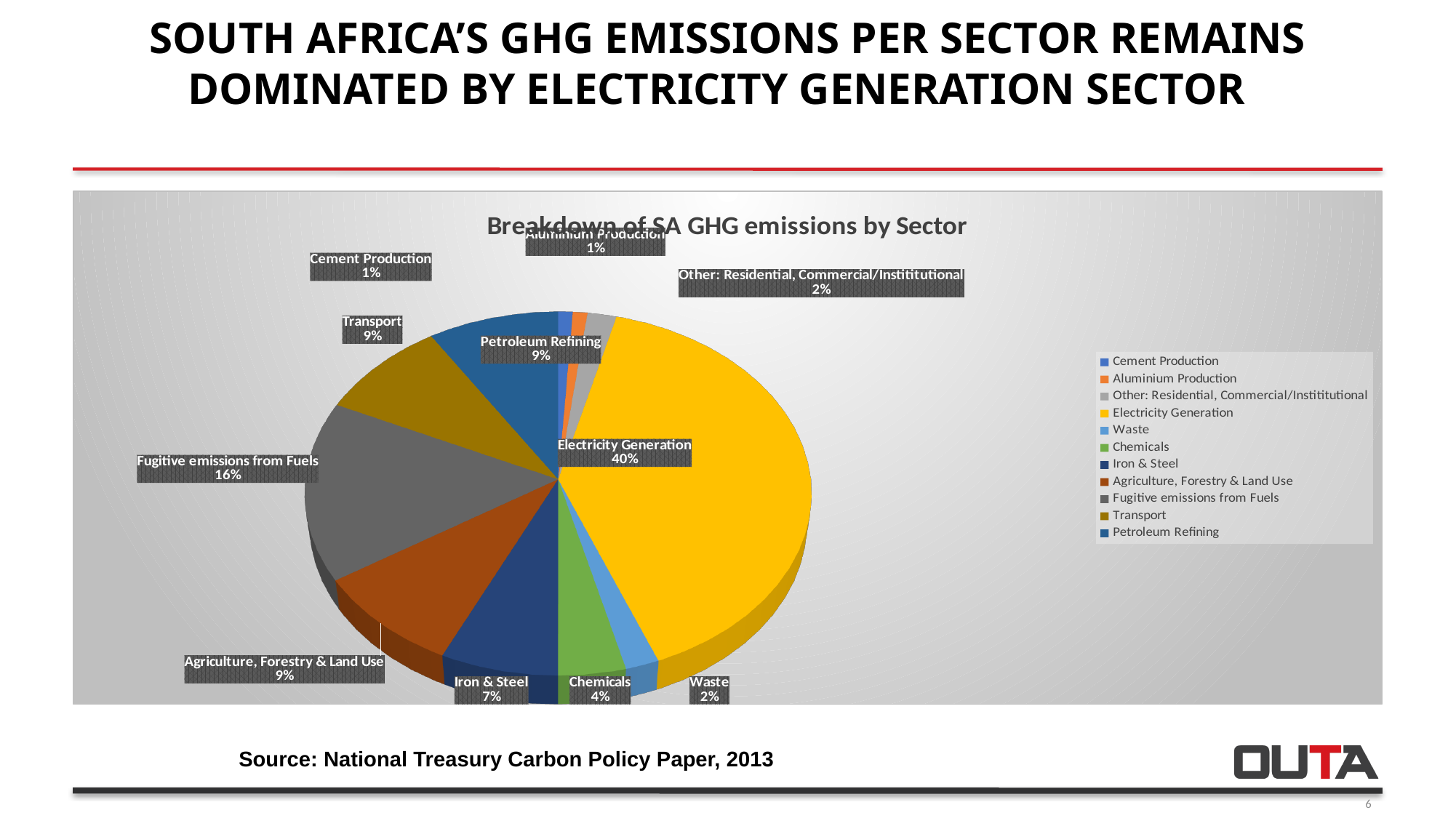
What share of SA GHG emissions does Electricity Generation account for? 40% What is the share for Iron & Steel? 7% What percentage is shown for Chemicals? 4% What is the combined share of Transport and Petroleum Refining? 18% What is the title of the chart? Breakdown of SA GHG emissions by Sector What percentage of emissions comes from Fugitive emissions from Fuels? 16% What is the difference in percentage points between Electricity Generation and Fugitive emissions from Fuels? 24 Which sector has the largest share of emissions? Electricity Generation What colour represents Electricity Generation in the pie chart? Yellow Which is larger, the share for Transport or the share for Iron & Steel? Transport What type of chart is shown on the slide? Pie chart How many sectors are listed in the legend? 11